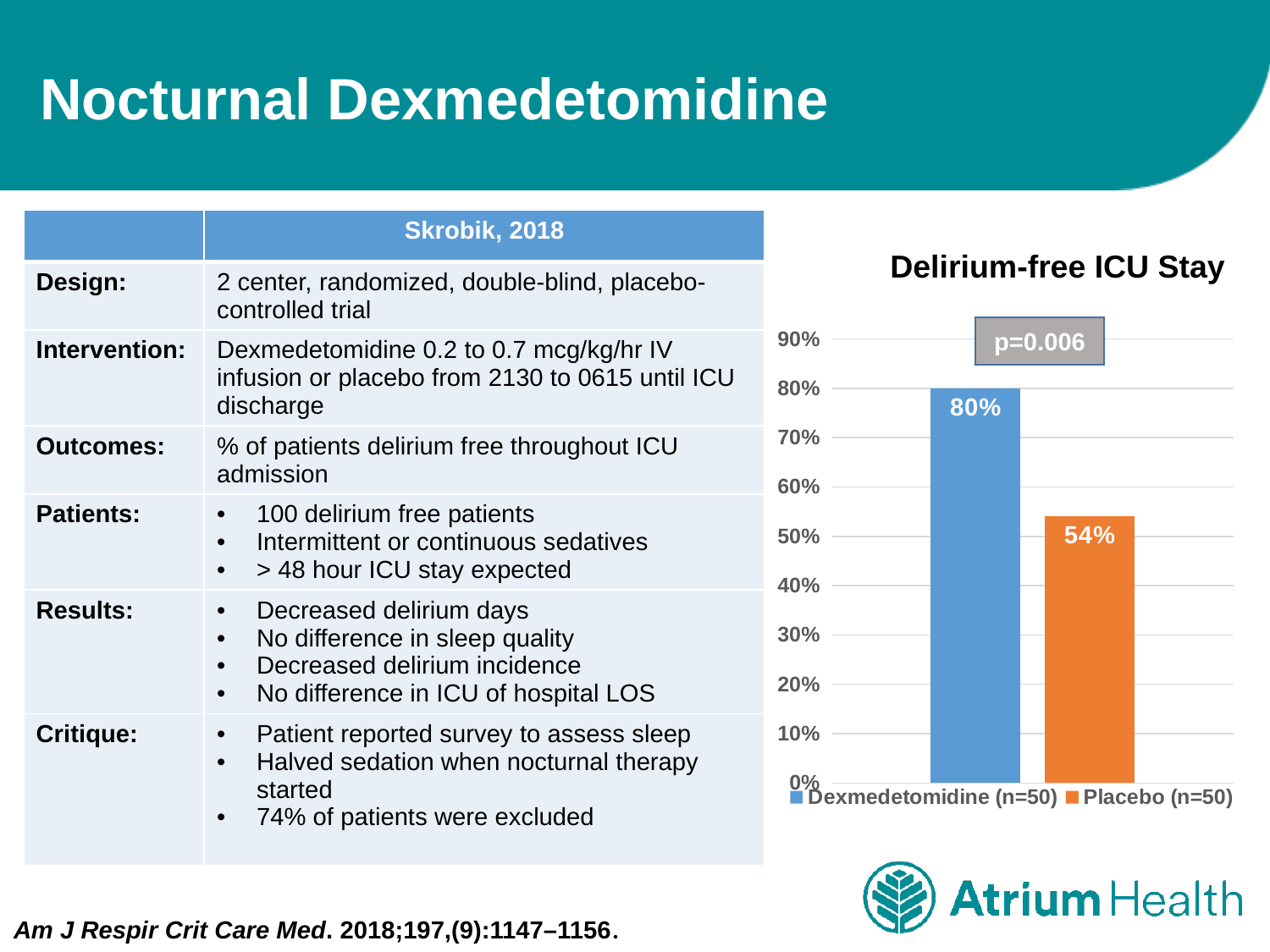
What is the title of the chart? Delirium-free ICU Stay What is the value for Placebo (n=50)? 54% Is the value for Placebo (n=50) greater or less than 60%? less How many bars are plotted in the chart? 2 Which group has the lower delirium-free ICU stay percentage? Placebo (n=50) What is the difference between the Dexmedetomidine and Placebo values? 26% What is the value for Dexmedetomidine (n=50)? 80% What p-value is shown on the chart? p=0.006 How many series does the legend list? 2 Which group has the higher delirium-free ICU stay percentage? Dexmedetomidine (n=50) Is the value for Dexmedetomidine (n=50) greater or less than 70%? greater What kind of chart is shown on the slide? bar chart